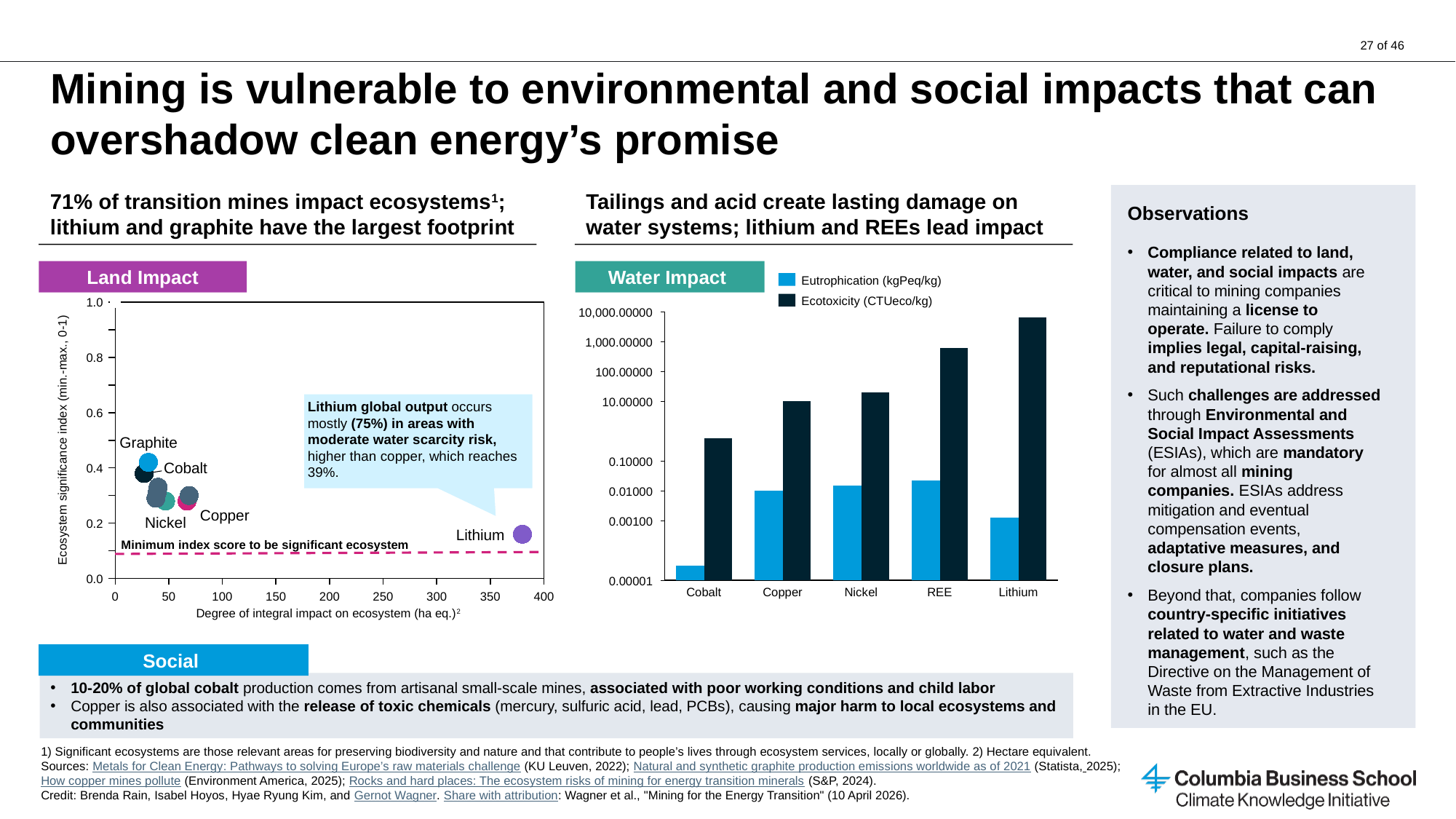
How many categories are shown on the x axis of the Water Impact chart? 5 In the Water Impact chart, do the Ecotoxicity values rise or fall moving from Cobalt to Lithium along the x axis? rise In the Water Impact chart, which category has the lowest Eutrophication value? Cobalt What kind of chart is the Water Impact chart? bar chart In the Land Impact chart, is the ecosystem significance index for Lithium greater or less than 0.2? less In the Water Impact chart, which category has the highest Ecotoxicity value? Lithium In the Water Impact chart, is the Ecotoxicity value for REE greater or less than 1,000? less How many series does the legend of the Water Impact chart list? 2 In the Land Impact chart, is the degree of integral impact for Lithium greater or less than 350? greater What kind of chart is the Land Impact chart? scatter plot In the Land Impact chart, which mineral has the highest degree of integral impact on ecosystem? Lithium